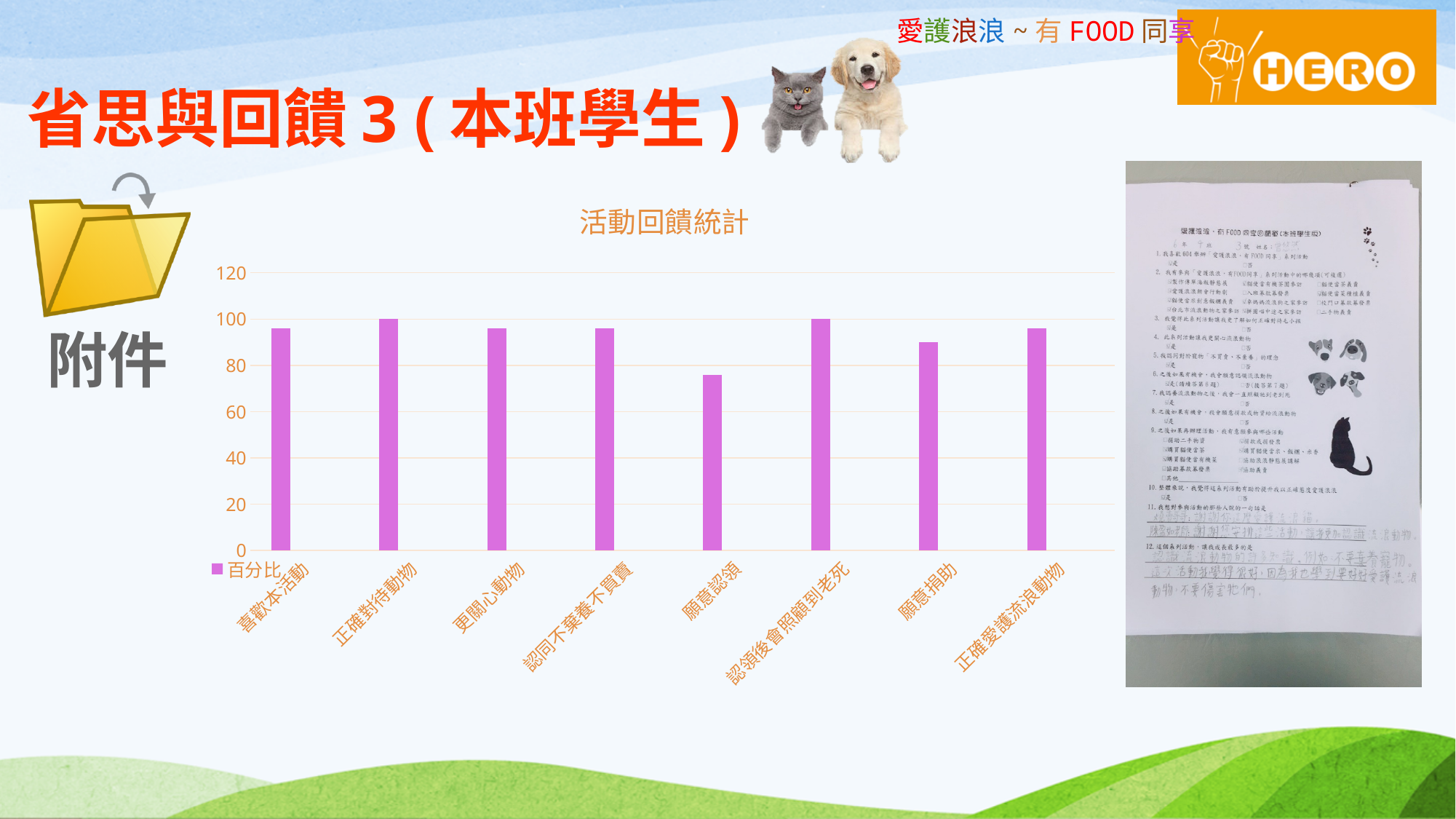
What kind of chart is shown on the slide? bar chart What is the value for 認領後會照顧到老死? 100 Which category has the lowest value? 願意認領 How many categories are shown on the x axis of the chart? 8 What is the value for 正確對待動物? 100 What is the title of the chart? 活動回饋統計 What is the name of the series shown in the chart legend? 百分比 Which is larger, the value for 願意捐助 or the value for 願意認領? 願意捐助 How many series does the chart legend list? 1 Which is larger, the value for 正確對待動物 or the value for 願意捐助? 正確對待動物 Is the value for 願意捐助 greater or less than 80? greater Is the value for 願意認領 greater or less than 80? less